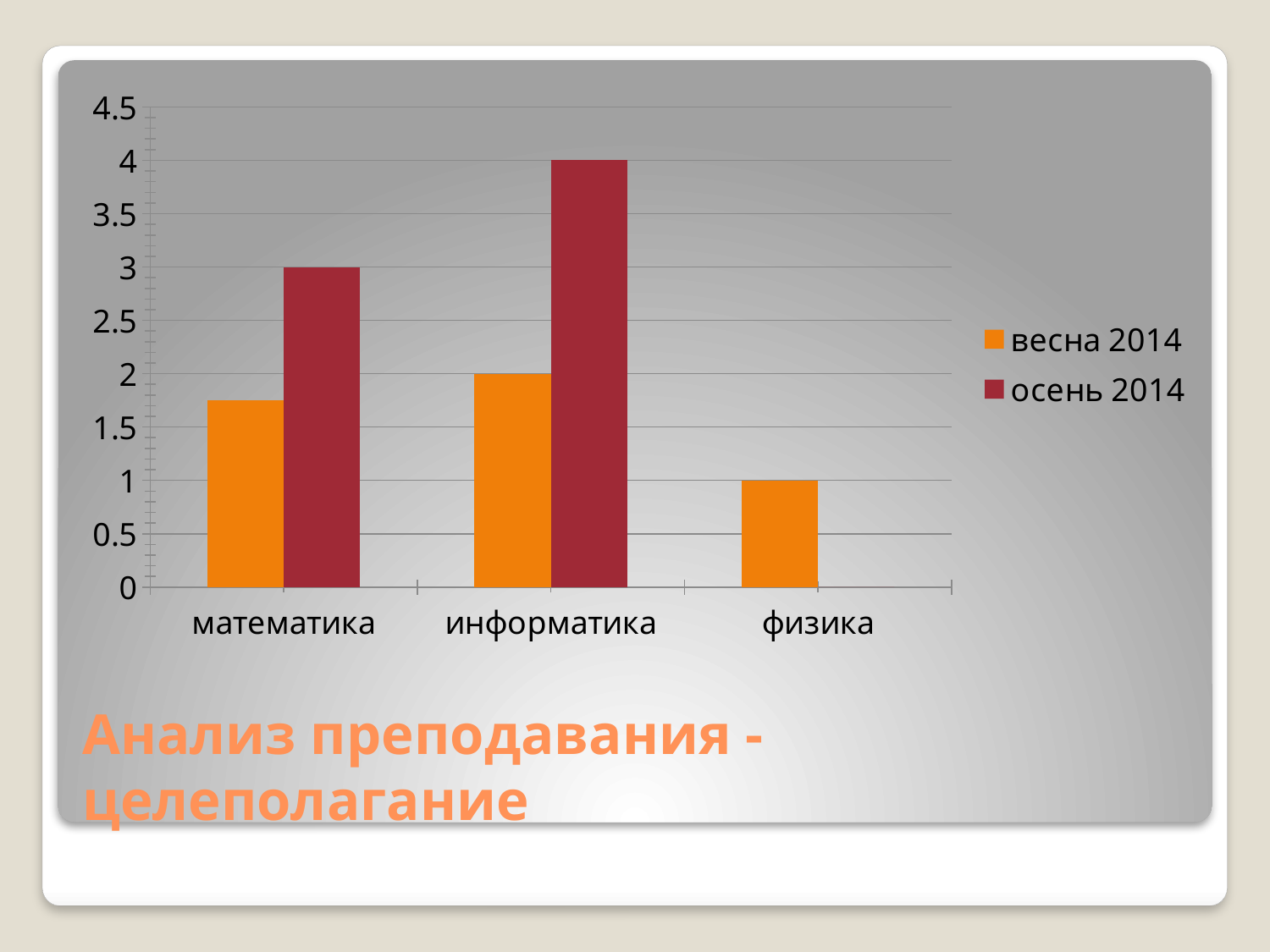
How many categories are shown on the x axis? 3 What is the value for информатика in the осень 2014 series? 4 Which category has the lowest value in the весна 2014 series? физика What is the difference between the осень 2014 and весна 2014 values for информатика? 2 What kind of chart is shown on the slide? bar chart What is the value for информатика in the весна 2014 series? 2 How many series does the legend list? 2 What is the value for математика in the осень 2014 series? 3 What is the value for физика in the весна 2014 series? 1 Which category has the highest value in the осень 2014 series? информатика Is the value for математика in the весна 2014 series greater or less than 2? less Which series is shown in orange according to the legend? весна 2014